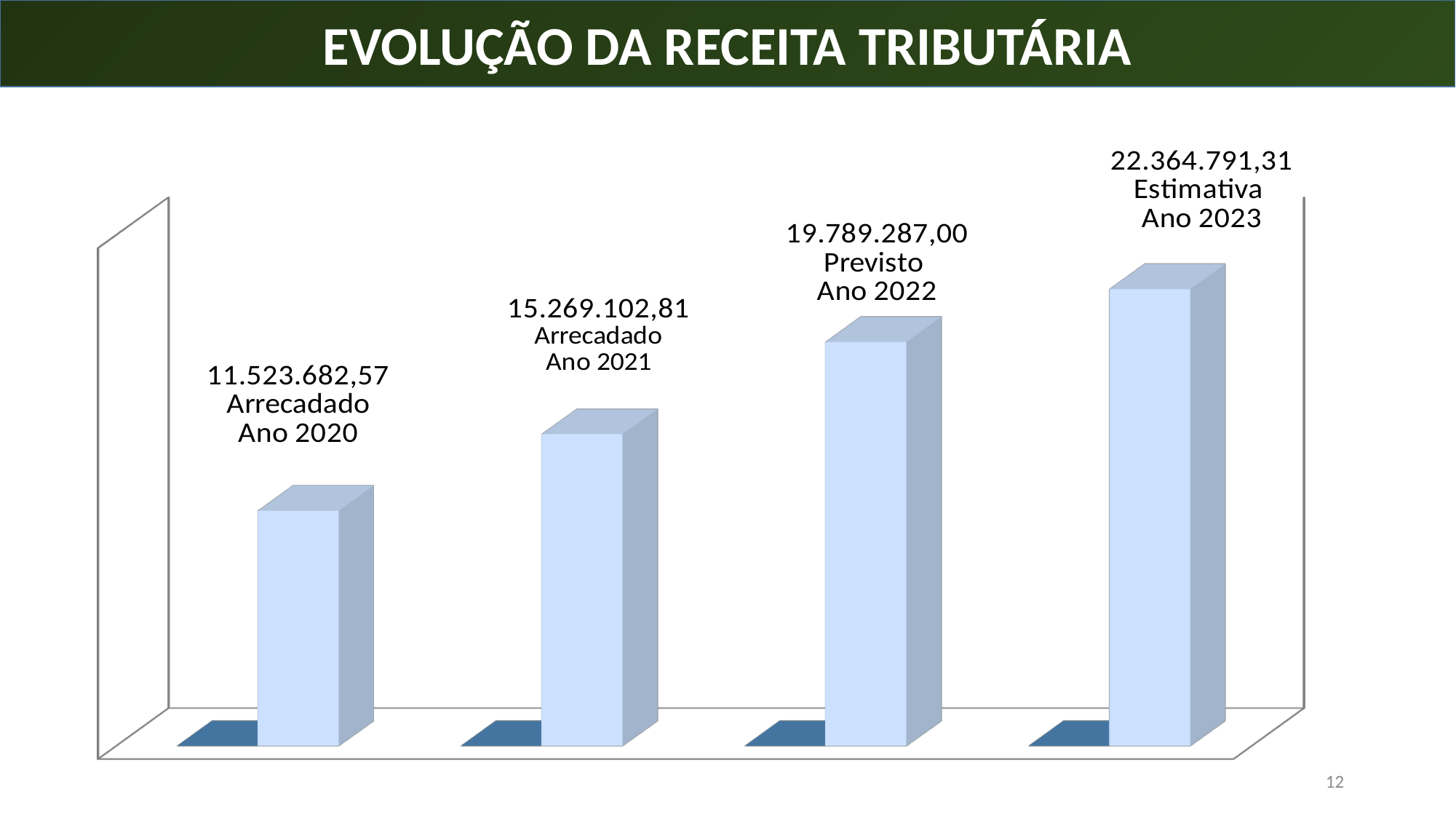
What is the value for Estimativa Ano 2023? 22.364.791,31 Which category has the highest value? Estimativa Ano 2023 What is the value for Previsto Ano 2022? 19.789.287,00 What kind of chart is shown on the slide? Bar chart What is the value for Arrecadado Ano 2021? 15.269.102,81 How many bars are shown in the chart? 4 What is the difference between the value for Estimativa Ano 2023 and the value for Previsto Ano 2022? 2.575.504,31 What is the difference between the value for Arrecadado Ano 2021 and the value for Arrecadado Ano 2020? 3.745.420,24 Do the values rise or fall from Ano 2020 to Ano 2023? Rise Which is larger, the value for Previsto Ano 2022 or the value for Arrecadado Ano 2021? Previsto Ano 2022 Which category has the lowest value? Arrecadado Ano 2020 What is the value for Arrecadado Ano 2020? 11.523.682,57